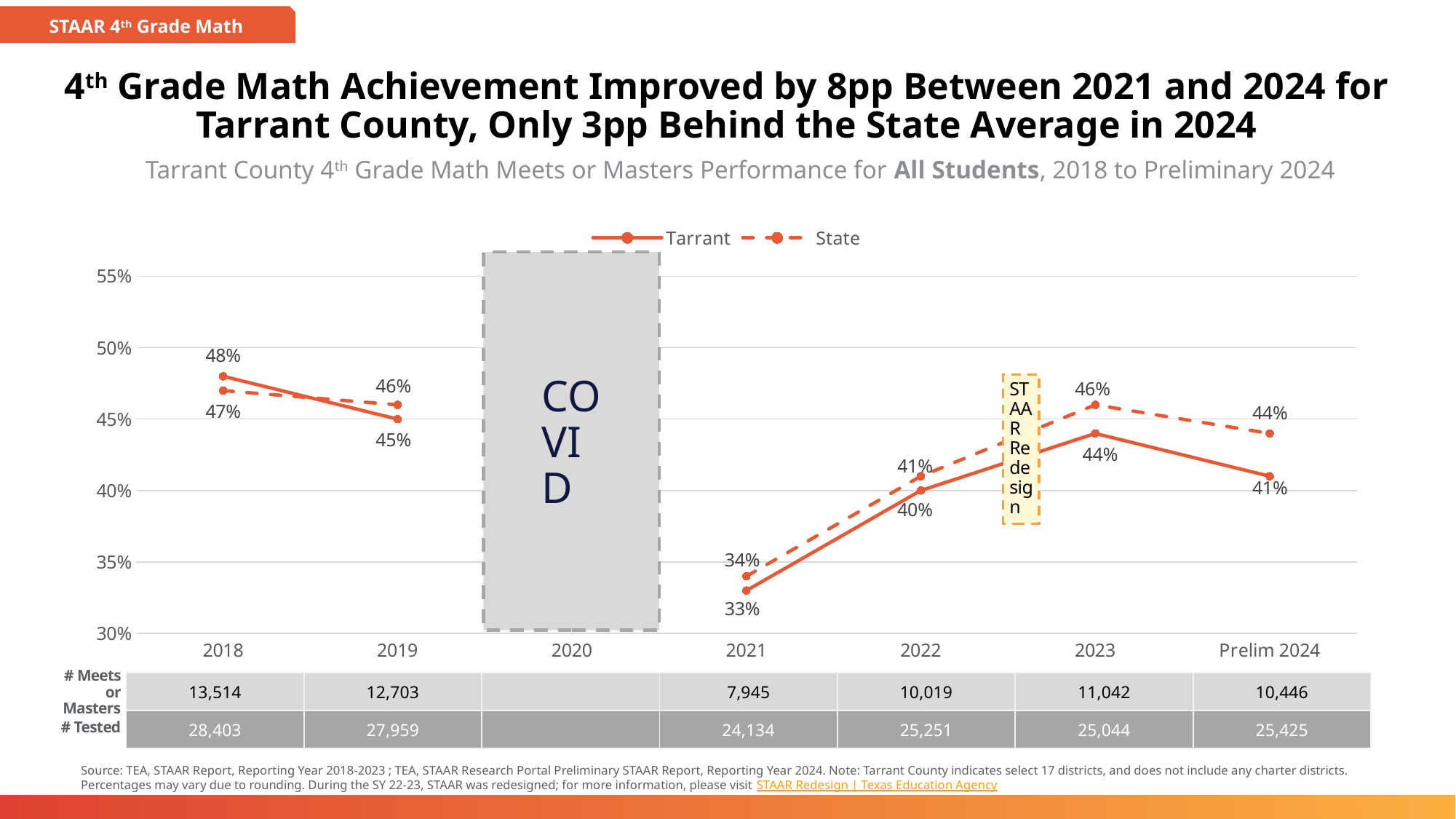
What is the # Tested value shown for 2022 in the table below the chart? 25,251 In which year is the Tarrant value highest? 2018 What is the Tarrant value for 2021? 33% What kind of chart is shown on the slide? Line chart What is the difference between the State and Tarrant values in 2023? 2pp Does the Tarrant value rise or fall from 2021 to 2023? Rise How many series does the legend list? 2 Which year on the x axis has no plotted data and is marked with a COVID box? 2020 Which is larger in 2019, the Tarrant value or the State value? State In which year is the Tarrant value lowest? 2021 What is the State value for Prelim 2024? 44% What is the Tarrant value for 2018? 48%